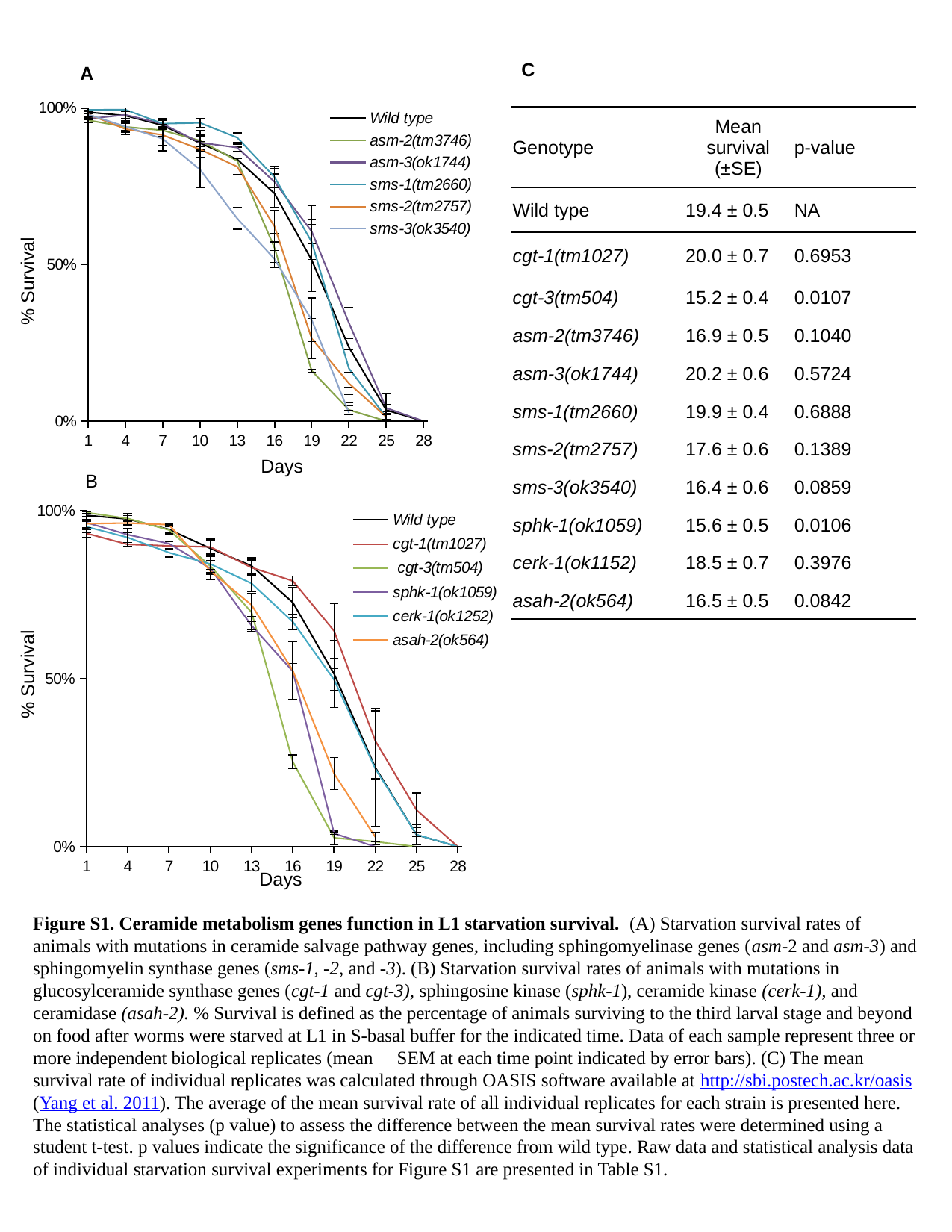
In panel B, do the survival values rise or fall as the days increase? fall What is the label of the y axis in panel B? % Survival In panel B, is the value for cgt-3(tm504) at day 16 greater or less than 50%? less In panel A, is the value for Wild type at day 13 greater or less than 50%? greater In panel A, is the value for asm-2(tm3746) at day 19 greater or less than 50%? less How many series does the legend of panel A list? 6 How many series does the legend of panel B list? 6 In panel B, which is larger at day 19: the value for cgt-1(tm1027) or the value for sphk-1(ok1059)? cgt-1(tm1027) In panel A, how many day values are marked on the x axis? 10 What kind of chart is panel A? line chart In panel A, do the survival values rise or fall as the days increase? fall